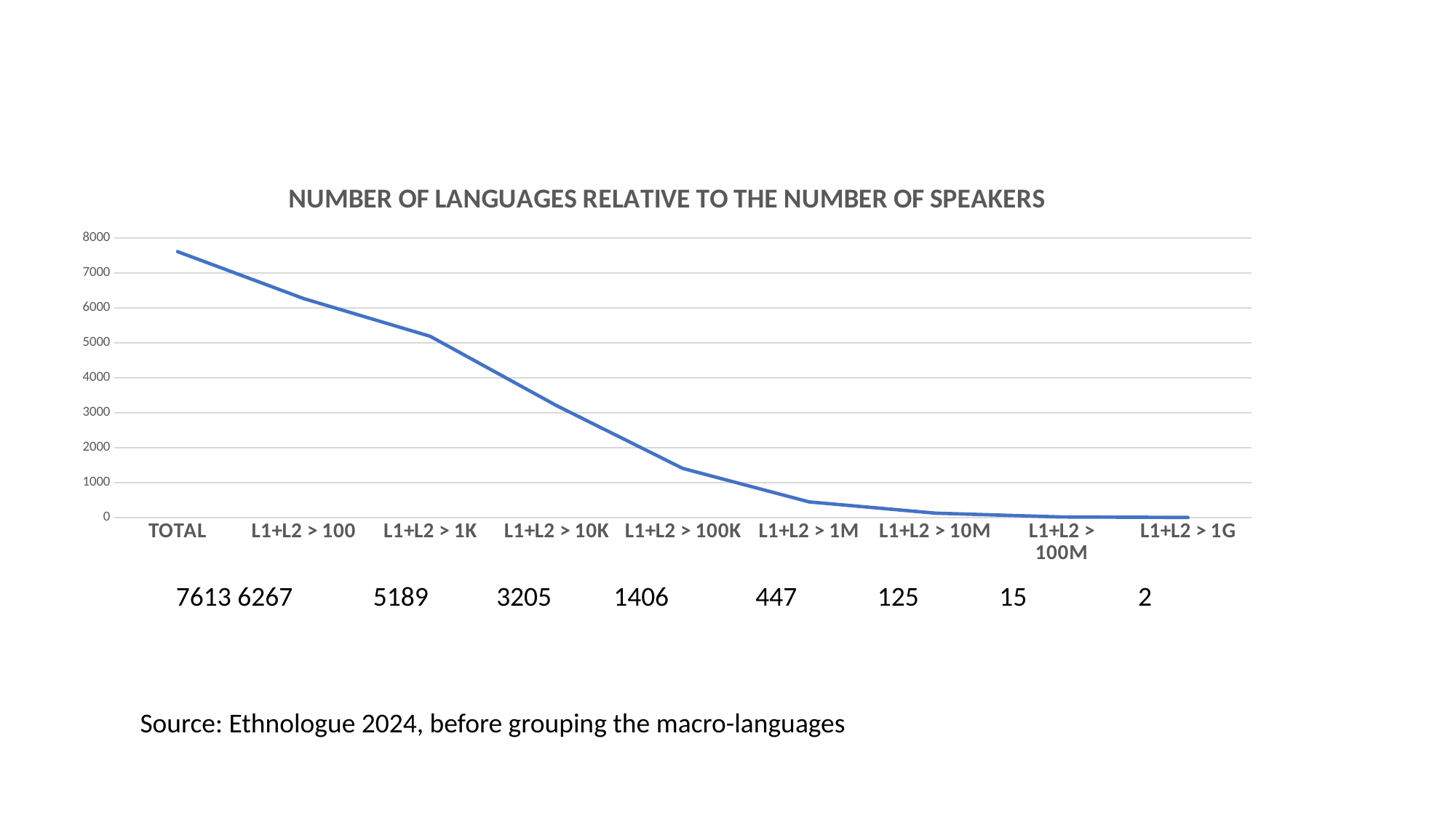
Which category has the highest value? TOTAL What is the difference between the values for L1+L2 > 1K and L1+L2 > 10K? 1984 Do the values rise or fall along the x axis from TOTAL to L1+L2 > 1G? fall What is the value for L1+L2 > 10K? 3205 What is the value for L1+L2 > 1M? 447 What type of chart is shown on the slide? line chart Which category has the lowest value? L1+L2 > 1G What is the title of the chart? NUMBER OF LANGUAGES RELATIVE TO THE NUMBER OF SPEAKERS What is the value for TOTAL? 7613 How many categories are plotted along the x axis? 9 Which is larger, the value for L1+L2 > 100K or the value for L1+L2 > 10M? L1+L2 > 100K What is the value for L1+L2 > 1G? 2